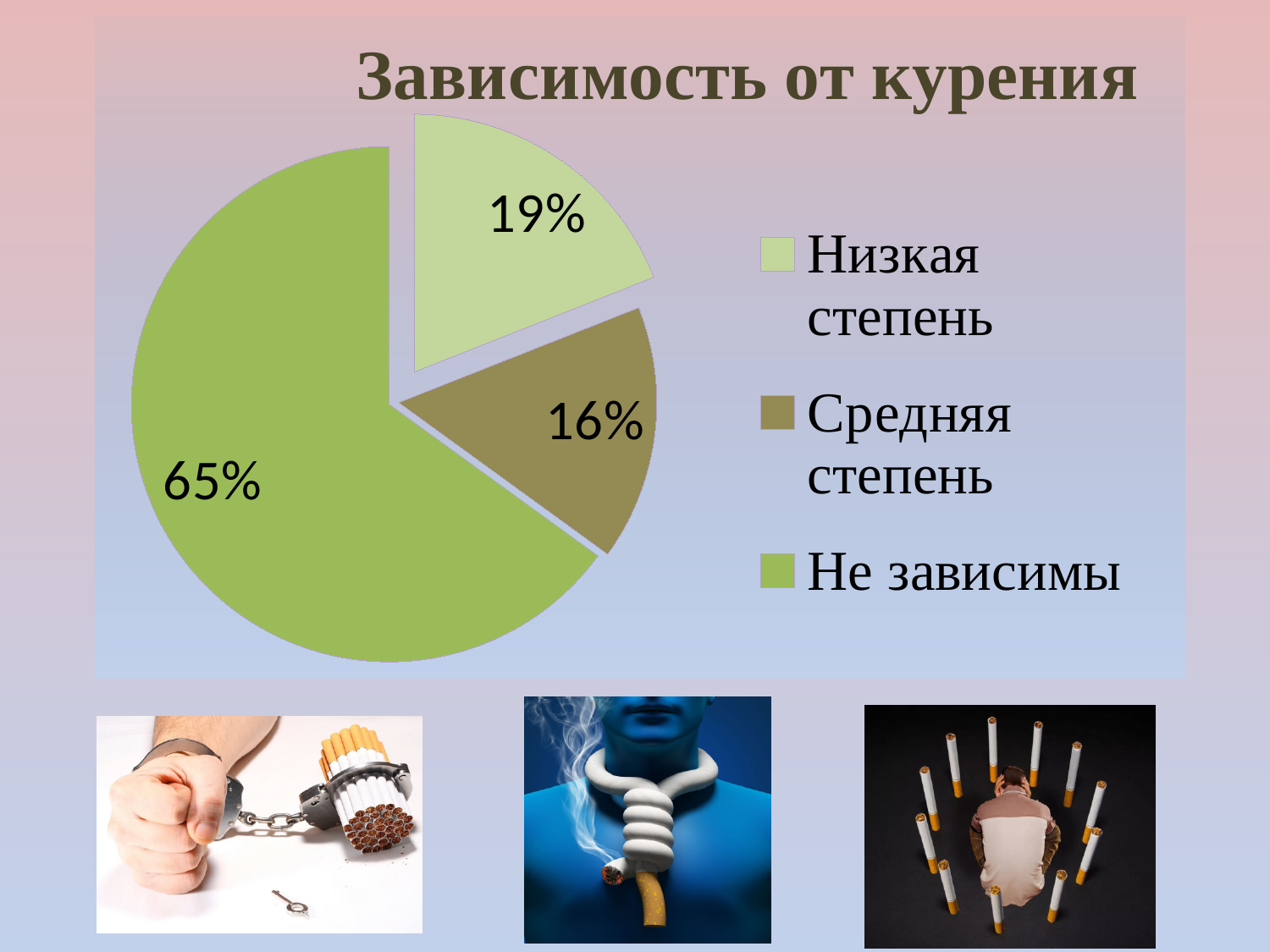
What is the difference in percentage points between "Низкая степень" and "Средняя степень"? 3 What percentage is shown for "Средняя степень"? 16% Which category has the smallest slice of the pie? Средняя степень What percentage is shown for "Не зависимы"? 65% Which category has the largest slice of the pie? Не зависимы How many slices does the pie chart have? 3 How many entries does the legend list? 3 What percentage is shown for "Низкая степень"? 19% What is the title of the chart? Зависимость от курения What is the difference in percentage points between "Не зависимы" and "Низкая степень"? 46 Which is larger: the slice for "Низкая степень" or the slice for "Средняя степень"? Низкая степень What type of chart is shown on the slide? pie chart